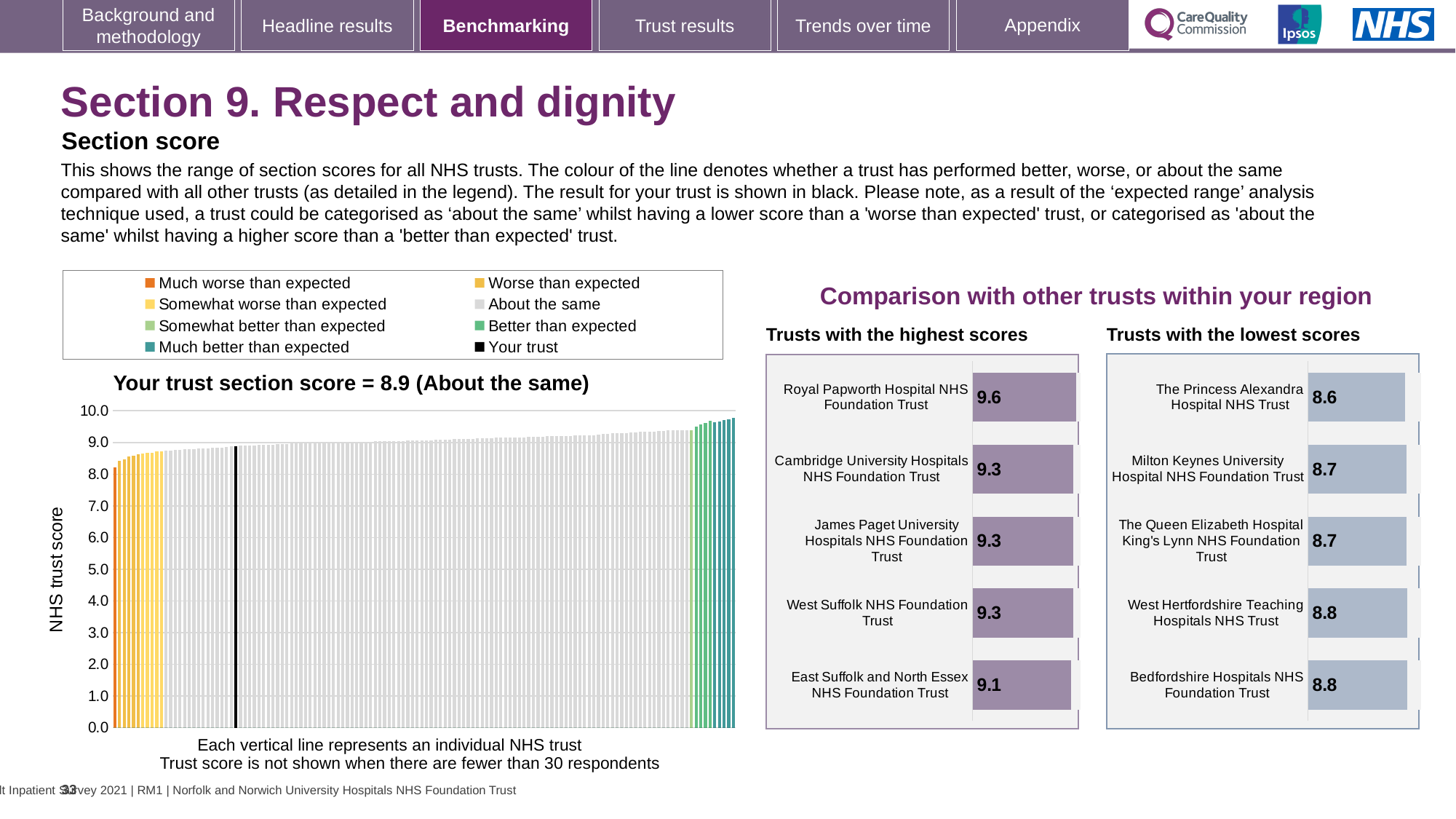
On the 'Your trust section score' chart, what is the section score for your trust? 8.9 On the 'Trusts with the highest scores' chart, which trust has the lowest score? East Suffolk and North Essex NHS Foundation Trust On the 'Trusts with the highest scores' chart, what is the score for Royal Papworth Hospital NHS Foundation Trust? 9.6 On the 'Trusts with the lowest scores' chart, what is the score for Milton Keynes University Hospital NHS Foundation Trust? 8.7 On the 'Your trust section score' chart, do the trust scores rise or fall from left to right along the x axis? rise On the 'Trusts with the highest scores' chart, what is the difference between the scores of Royal Papworth Hospital NHS Foundation Trust and East Suffolk and North Essex NHS Foundation Trust? 0.5 On the 'Trusts with the highest scores' chart, how many trusts are shown? 5 On the 'Trusts with the lowest scores' chart, which has the higher score: Milton Keynes University Hospital NHS Foundation Trust or West Hertfordshire Teaching Hospitals NHS Trust? West Hertfordshire Teaching Hospitals NHS Trust On the 'Your trust section score' chart, what is the label on the vertical axis? NHS trust score On the 'Your trust section score' chart, what kind of chart is shown? bar chart On the 'Trusts with the lowest scores' chart, which trust has the lowest score? The Princess Alexandra Hospital NHS Trust How many entries does the legend above the 'Your trust section score' chart list? 8